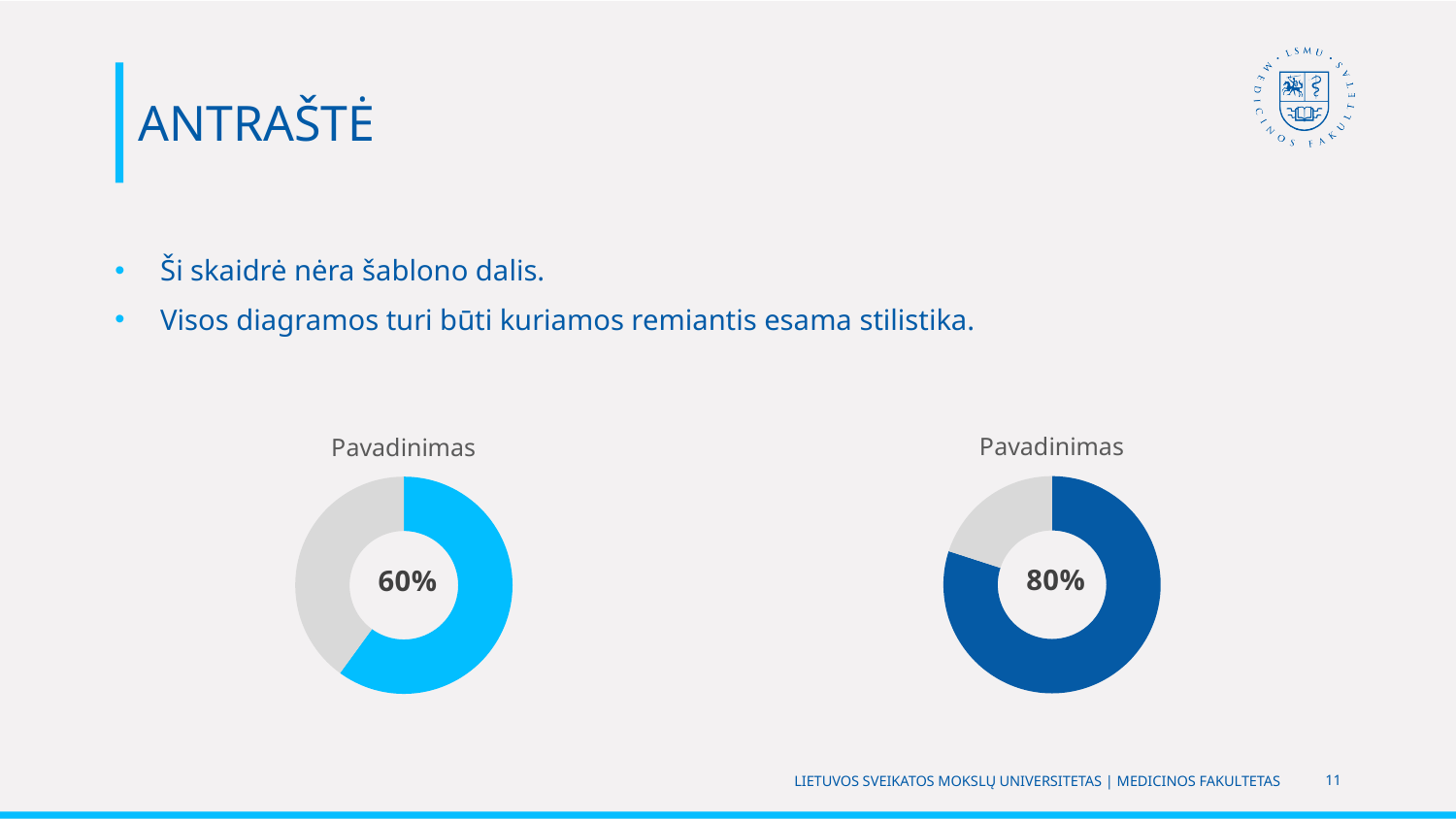
Which chart shows the larger highlighted percentage, the left chart or the right chart? The right chart How many segments does the right donut chart have? 2 What is the title shown above the left chart? Pavadinimas What value is printed in the centre of the right donut chart? 80% What kind of chart is the right chart on the slide? Donut chart In the right chart, what share of the donut is the grey segment? 20% What value is printed in the centre of the left donut chart? 60% In the left chart, what share of the donut is the grey segment? 40% What kind of chart is the left chart on the slide? Donut chart What is the difference between the percentage shown in the right chart and the percentage shown in the left chart? 20 percentage points How many segments does the left donut chart have? 2 What colour is the highlighted segment in the right chart? Dark blue